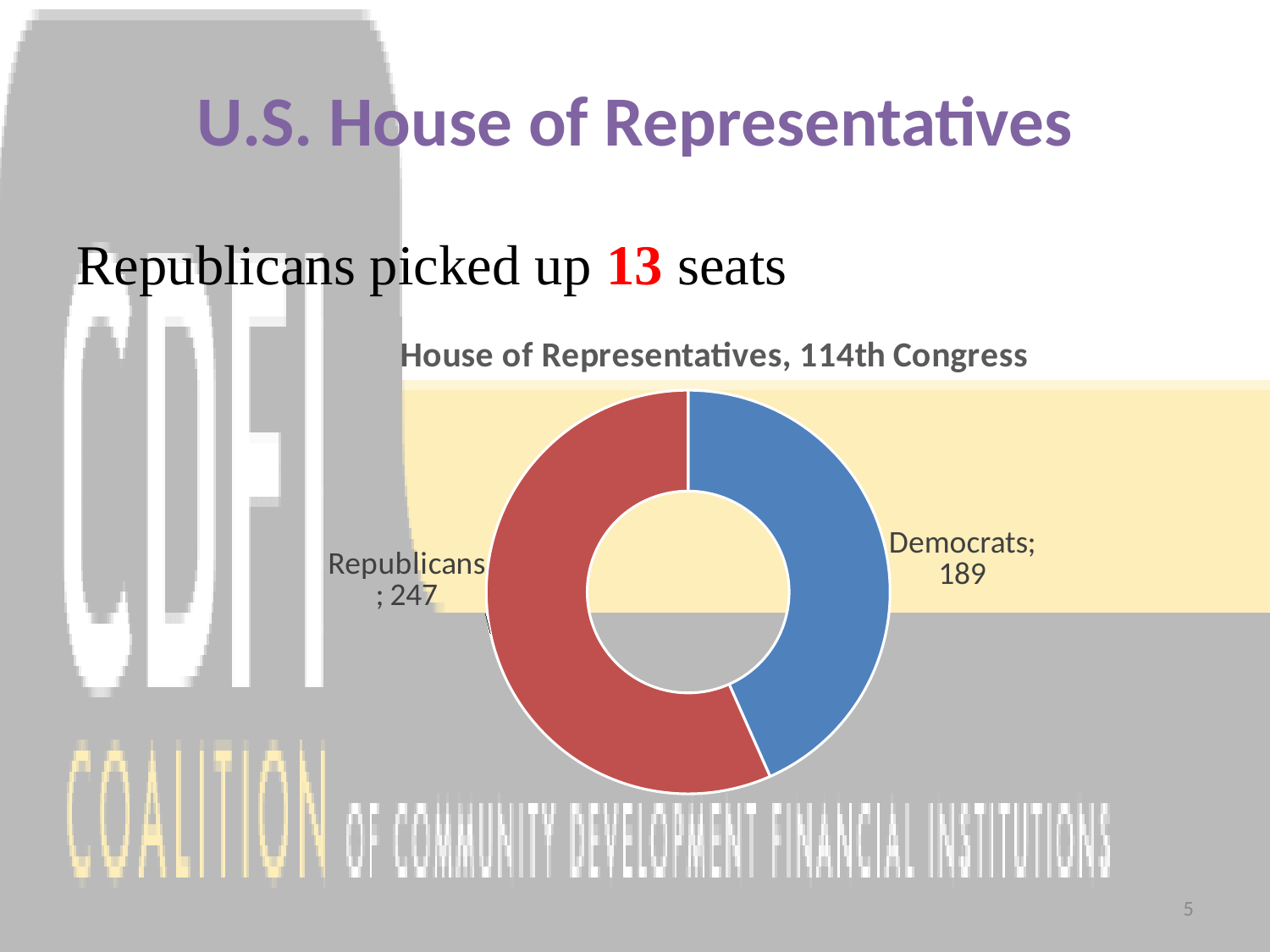
What share of the chart's total do Republicans represent, to one decimal place? 56.7% Which party has the smaller share of the chart? Democrats What is the difference between the Republican and Democratic seat counts shown in the chart? 58 What colour is the Republicans segment of the chart? red What is the title of the chart? House of Representatives, 114th Congress How many seats do Republicans hold according to the chart? 247 What kind of chart is shown on the slide? doughnut chart Is the Democrats' value larger or smaller than the Republicans' value? smaller Which party has the larger share of the chart? Republicans How many categories does the chart show? 2 What is the total number of seats represented in the chart? 436 How many seats do Democrats hold according to the chart? 189